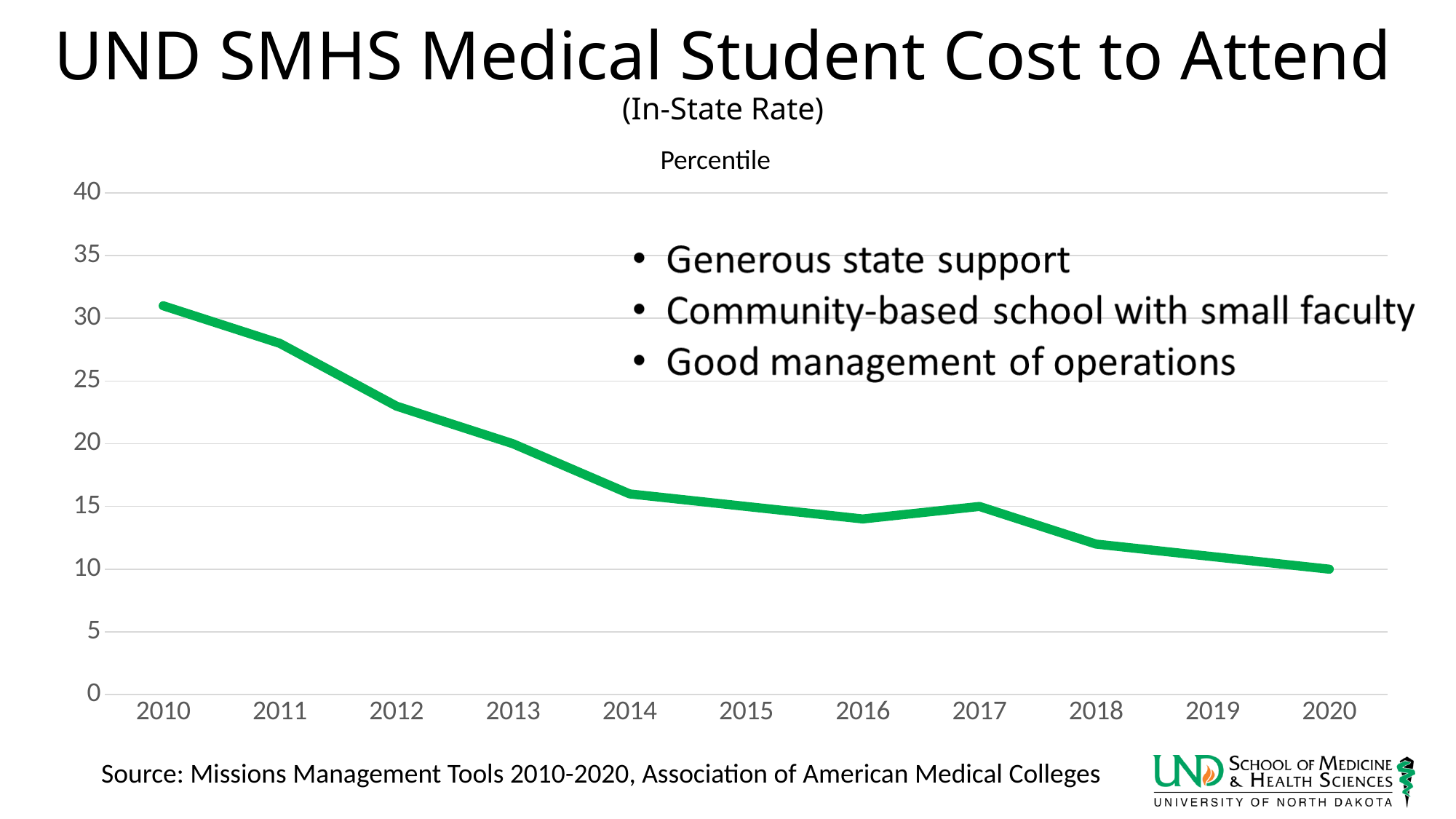
What label is shown above the y axis of the chart? Percentile Which year has the larger value, 2011 or 2017? 2011 Which year has the highest percentile value? 2010 What is the percentile value for 2020? 10 Which year has the lowest percentile value? 2020 How many years are plotted along the x axis? 11 What kind of chart is shown on the slide? line chart Do the values generally rise or fall from 2010 to 2020? fall Is the value for 2010 greater or less than 30? greater Is the value for 2018 greater or less than 15? less Is the value for 2014 greater or less than 15? greater